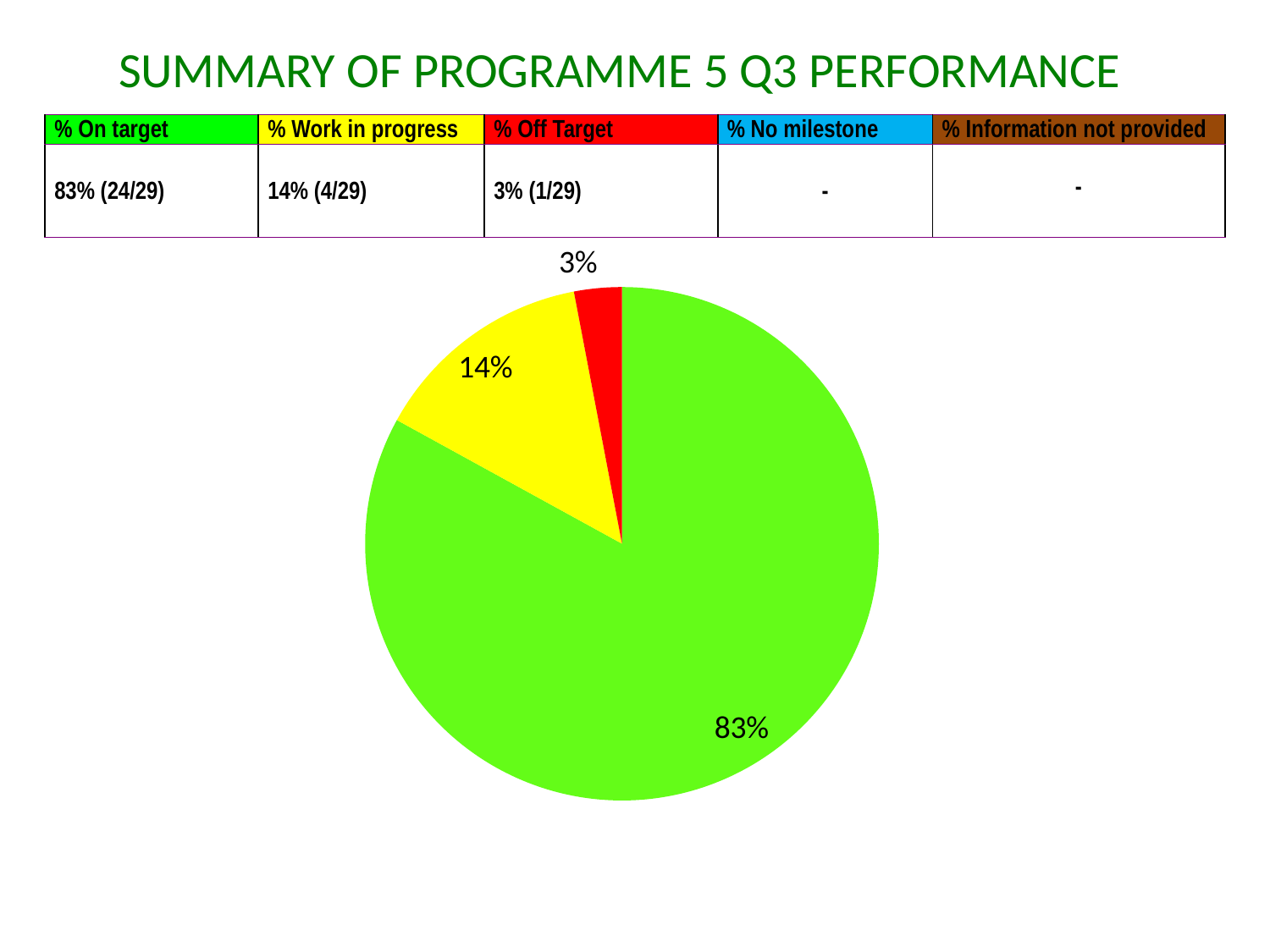
What share of the pie does the yellow (Work in progress) slice represent? 14% Which is larger, the Work in progress slice or the Off Target slice? Work in progress Which category has the smallest slice of the pie? Off Target What colour is the slice labelled 83%? green What is the combined share of the Work in progress and Off Target slices? 17% What is the difference in percentage points between the On target slice and the Work in progress slice? 69 What kind of chart is shown on the slide? pie chart What share of the pie does the red (Off Target) slice represent? 3% What share of the pie does the green (On target) slice represent? 83% Which category has the largest slice of the pie? On target How many slices does the pie chart have? 3 What is the title of the slide containing the pie chart? SUMMARY OF PROGRAMME 5 Q3 PERFORMANCE